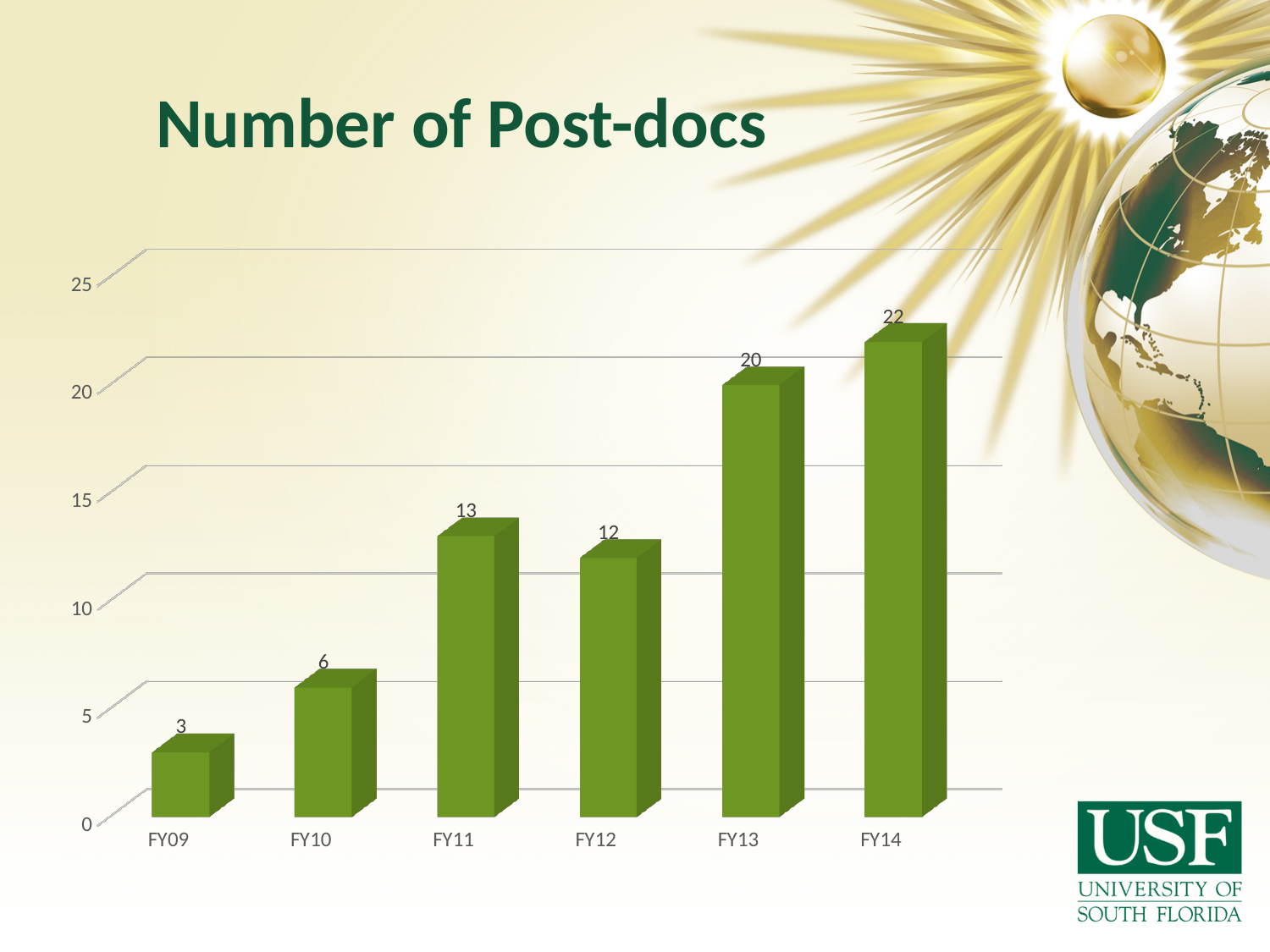
What is the title of the chart? Number of Post-docs What is the difference in the number of post-docs between FY14 and FY09? 19 What is the number of post-docs for FY09? 3 Which fiscal year has the highest number of post-docs? FY14 What kind of chart is shown on the slide? Bar chart How many fiscal years are shown on the chart? 6 What is the number of post-docs for FY11? 13 What is the number of post-docs for FY13? 20 Which fiscal year has the lowest number of post-docs? FY09 Which has more post-docs, FY10 or FY12? FY12 What is the difference in the number of post-docs between FY11 and FY12? 1 Is the value for FY13 greater or less than 15? greater